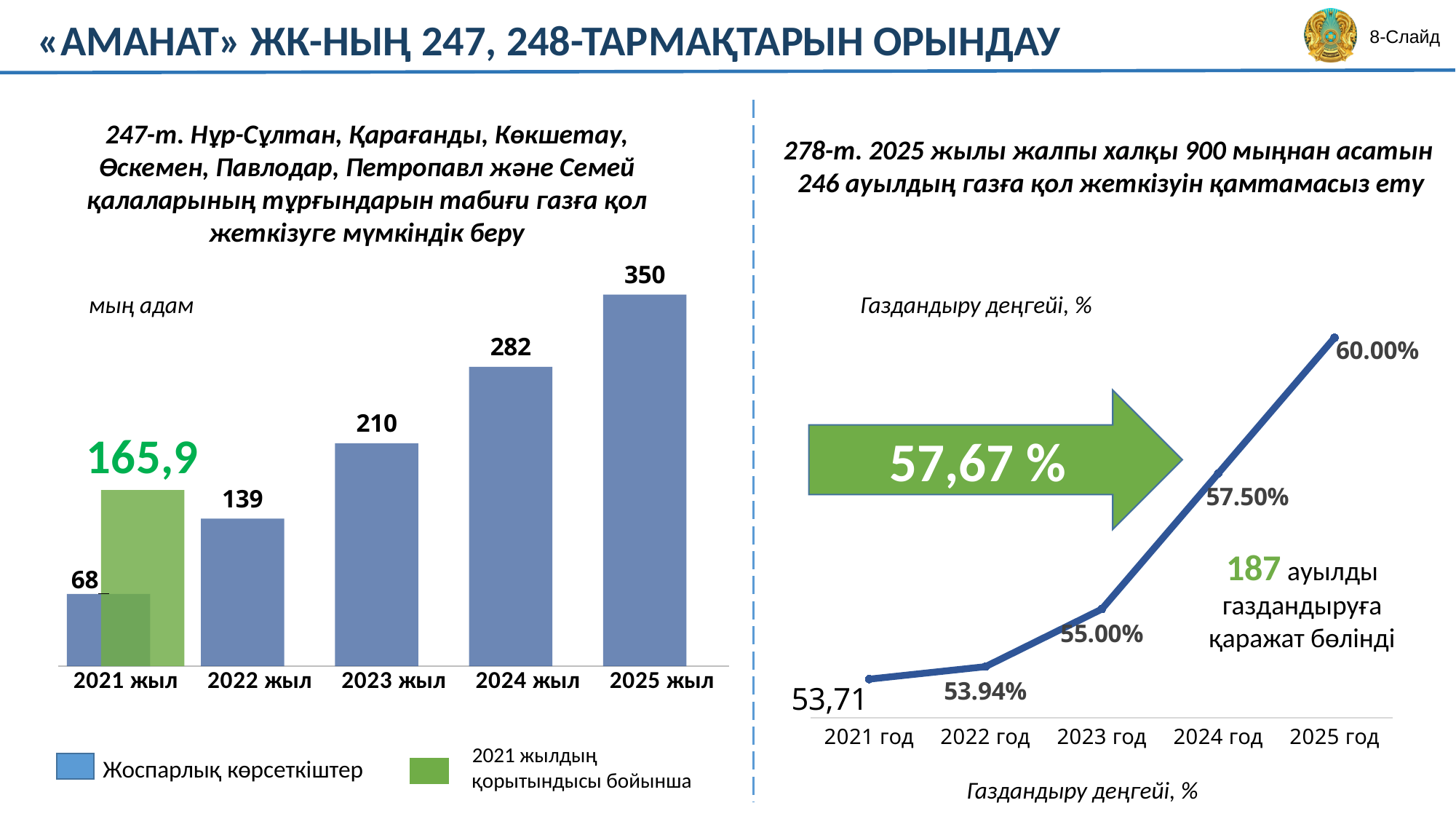
In the right line chart (Газдандыру деңгейі, %), how many years are plotted on the x axis? 5 In the left bar chart, what is the planned value (Жоспарлық көрсеткіштер) for 2022 жыл? 139 In the left bar chart, which year has the highest planned value? 2025 жыл In the right line chart (Газдандыру деңгейі, %), do the values rise or fall from 2021 год to 2025 год? rise In the left bar chart, what is the planned value for 2025 жыл? 350 In the right line chart (Газдандыру деңгейі, %), what is the value for 2025 год? 60.00% In the left bar chart, how many series does the legend list? 2 What type of chart is the left chart on the slide? bar chart In the left bar chart, which year has the lowest planned value? 2021 жыл In the left bar chart, what is the 2021 actual value (2021 жылдың қорытындысы бойынша) shown by the green bar? 165,9 In the left bar chart, what is the difference between the planned values for 2024 жыл and 2023 жыл? 72 In the right line chart (Газдандыру деңгейі, %), what is the value for 2023 год? 55.00%